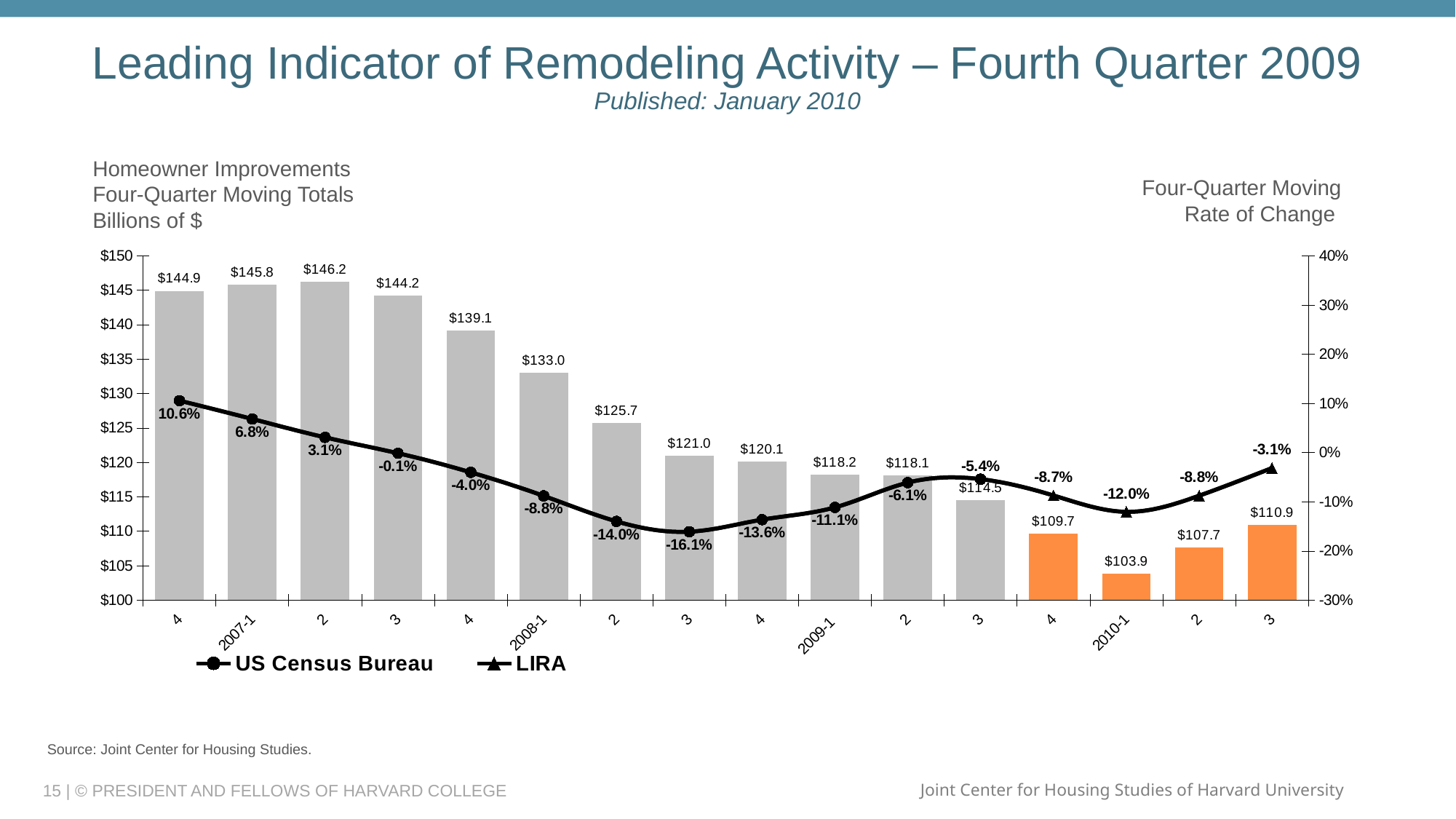
Which is larger, the Homeowner Improvements bar for 2010 Q2 or for 2010 Q3? 2010 Q3 ($110.9) How many bars are plotted in the chart? 16 What is the LIRA rate of change value for 2010 Q3? -3.1% What is the value of the Homeowner Improvements bar for 2007-1? $145.8 Which quarter has the highest Homeowner Improvements bar? 2007 Q2 ($146.2) What is the Four-Quarter Moving Rate of Change for 2009-1? -11.1% What colour are the bars for 2009 Q4 through 2010 Q3? Orange What is the difference between the Homeowner Improvements bars for 2008-1 and 2009-1? $14.8 What is the value of the Homeowner Improvements bar for 2010-1? $103.9 Which quarter has the lowest Homeowner Improvements bar? 2010-1 ($103.9) How many series does the legend list? 2 What is the lowest Four-Quarter Moving Rate of Change shown on the line? -16.1%